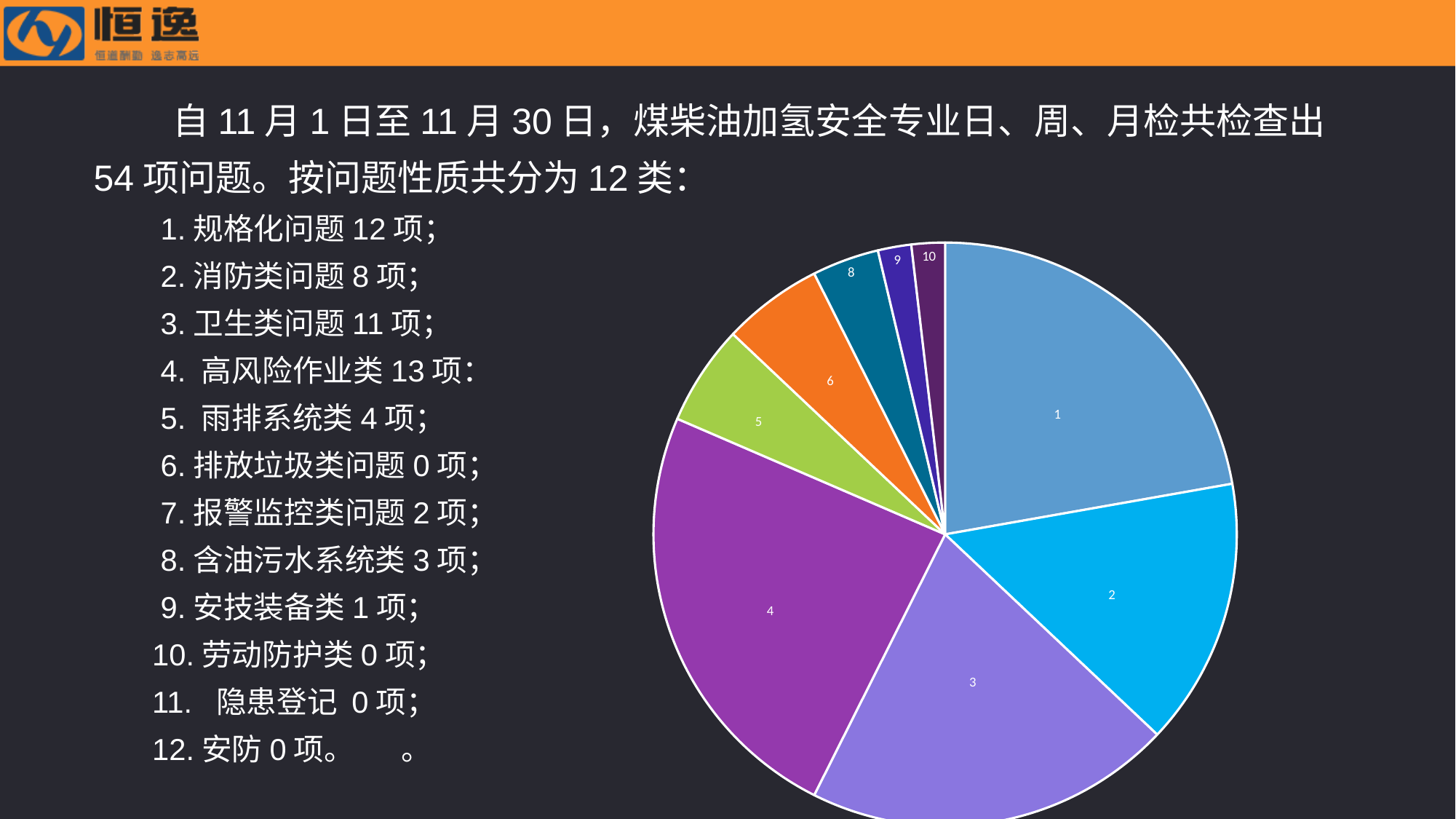
Which slice of the pie chart is larger, slice 6 or slice 9? 6 Which slice of the pie chart is larger, slice 3 or slice 2? 3 Which slice of the pie chart is larger, slice 1 or slice 2? 1 What colour is slice 4 in the pie chart? purple What colour is slice 6 in the pie chart? orange Which numbered slice of the pie chart is the largest? 4 What kind of chart is shown on the slide? pie chart